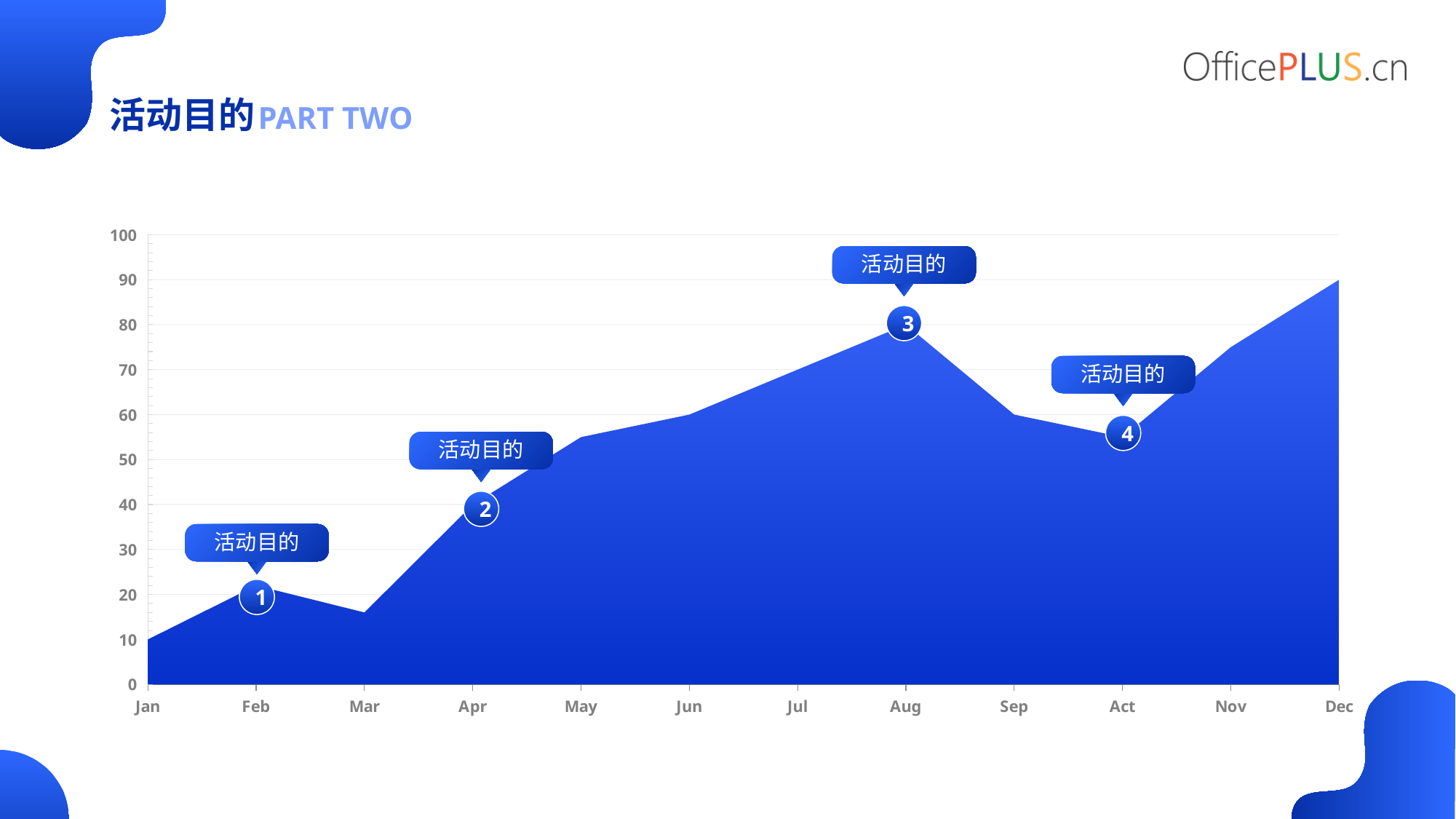
What is the value for Aug in the chart? 80 Which month has the highest value in the chart? Dec Which month has the larger value, Aug or Sep? Aug How many months are shown along the x axis of the chart? 12 What is the value for Jan in the chart? 10 What is the difference between the values for Dec and Jan? 80 Is the value for May greater or less than 50? greater What is the value for Dec in the chart? 90 What kind of chart is shown on the slide? area chart Which month has the lowest value in the chart? Jan Is the value for Mar greater or less than 20? less Do the values rise or fall from Jan to Aug? rise